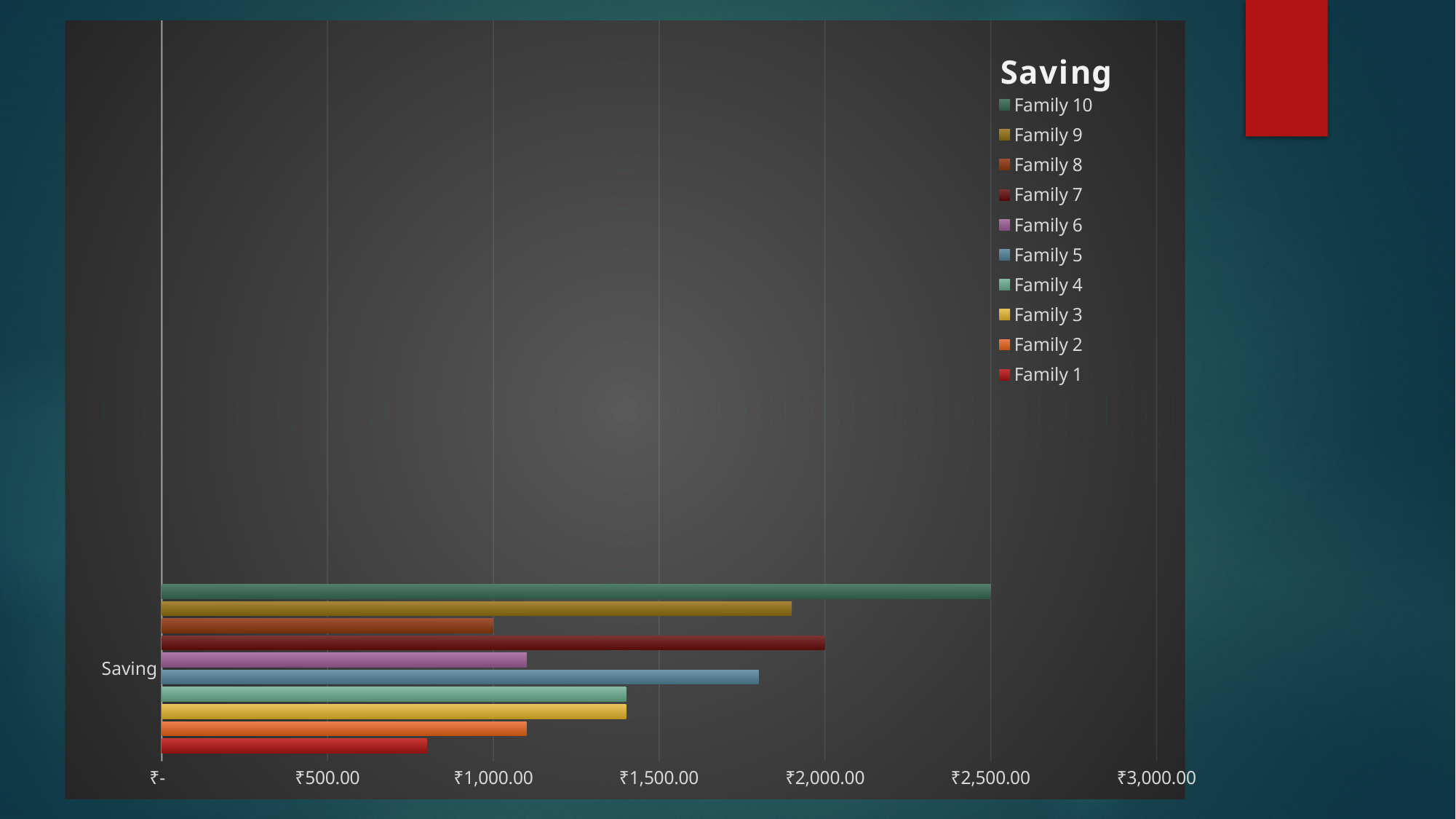
Which is larger, the saving for Family 5 or for Family 6? Family 5 Which family has the highest saving? Family 10 What is the saving value for Family 10? ₹2,500.00 Is the saving for Family 9 greater or less than ₹1,500.00? greater How many series does the legend list? 10 What is the title of the chart? Saving What is the saving value for Family 7? ₹2,000.00 How many categories are shown on the vertical axis? 1 Which family has the lowest saving? Family 1 What kind of chart is shown on the slide? bar chart What is the saving value for Family 8? ₹1,000.00 Is the saving for Family 1 greater or less than ₹1,000.00? less